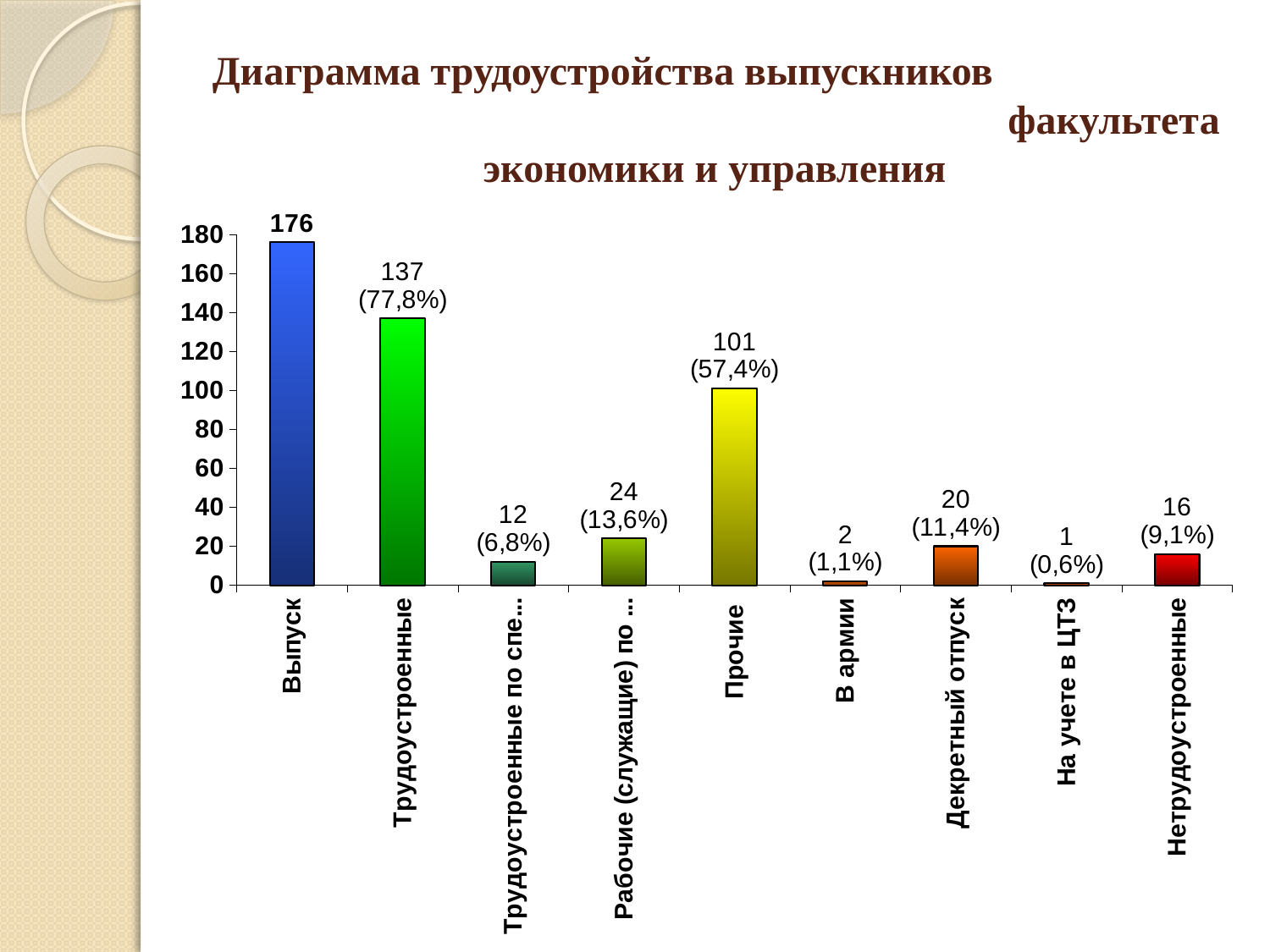
Which category has the highest value? Выпуск What percentage is shown for Нетрудоустроенные? 9,1% What is the difference between the values for В армии and На учете в ЦТЗ? 1 What is the difference between the values for Выпуск and Трудоустроенные? 39 Which is larger, the value for Декретный отпуск or the value for Нетрудоустроенные? Декретный отпуск What is the value for Выпуск? 176 How many categories are plotted on the chart? 9 What is the value for Трудоустроенные? 137 What percentage is shown for Прочие? 57,4% Which category has the lowest value? На учете в ЦТЗ What is the value for Декретный отпуск? 20 What type of chart is shown on the slide? Bar chart